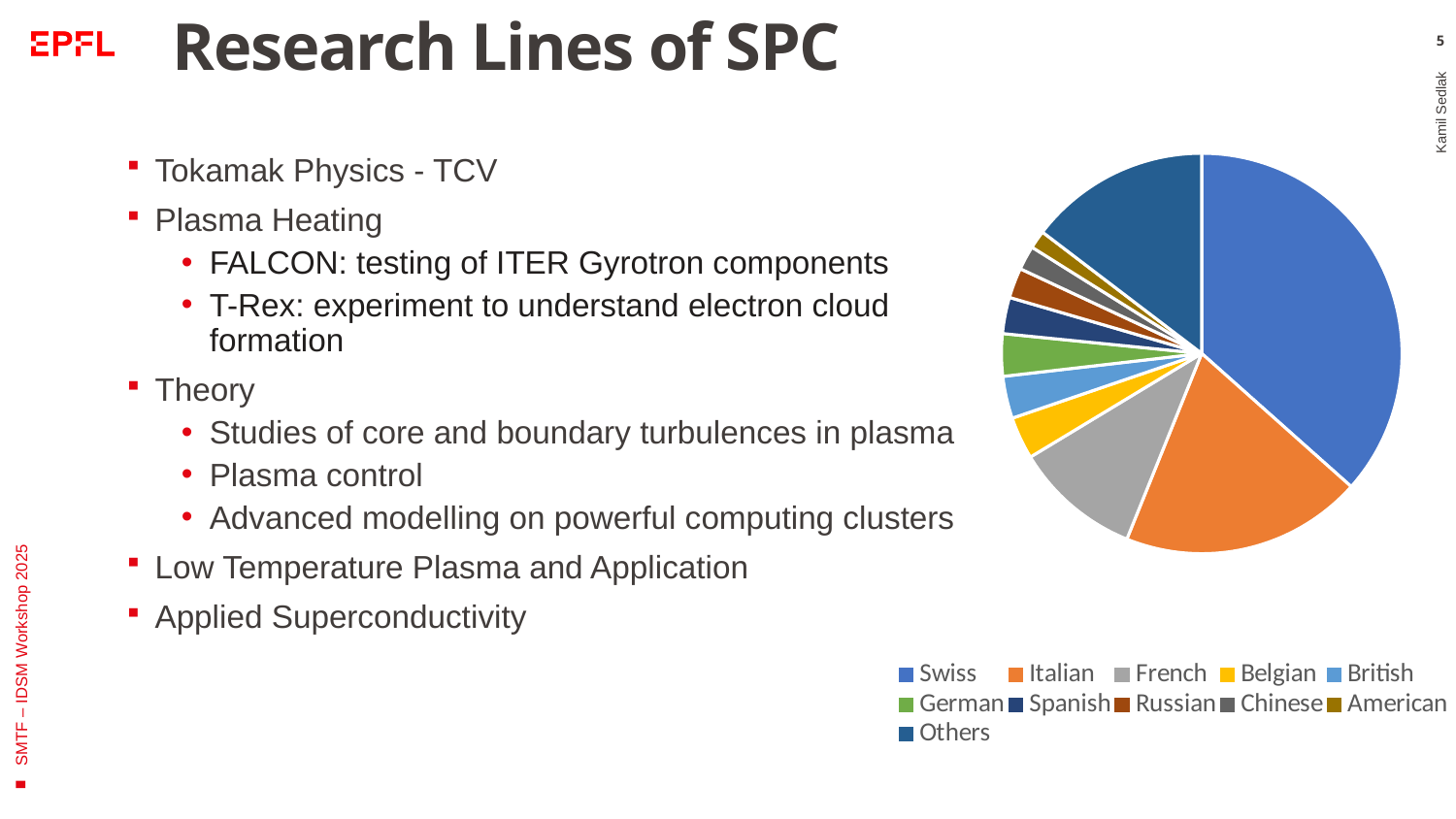
Which slice is larger in the pie chart, Italian or French? Italian Which category has the largest slice of the pie chart? Swiss What kind of chart is shown on the slide? pie chart What is the last entry listed in the pie chart's legend? Others Which category has the second-largest slice of the pie chart? Italian Which slice is larger in the pie chart, Swiss or Others? Swiss How many categories does the pie chart's legend list? 11 Which slice is larger in the pie chart, Swiss or Italian? Swiss What colour is the Swiss slice in the pie chart? blue